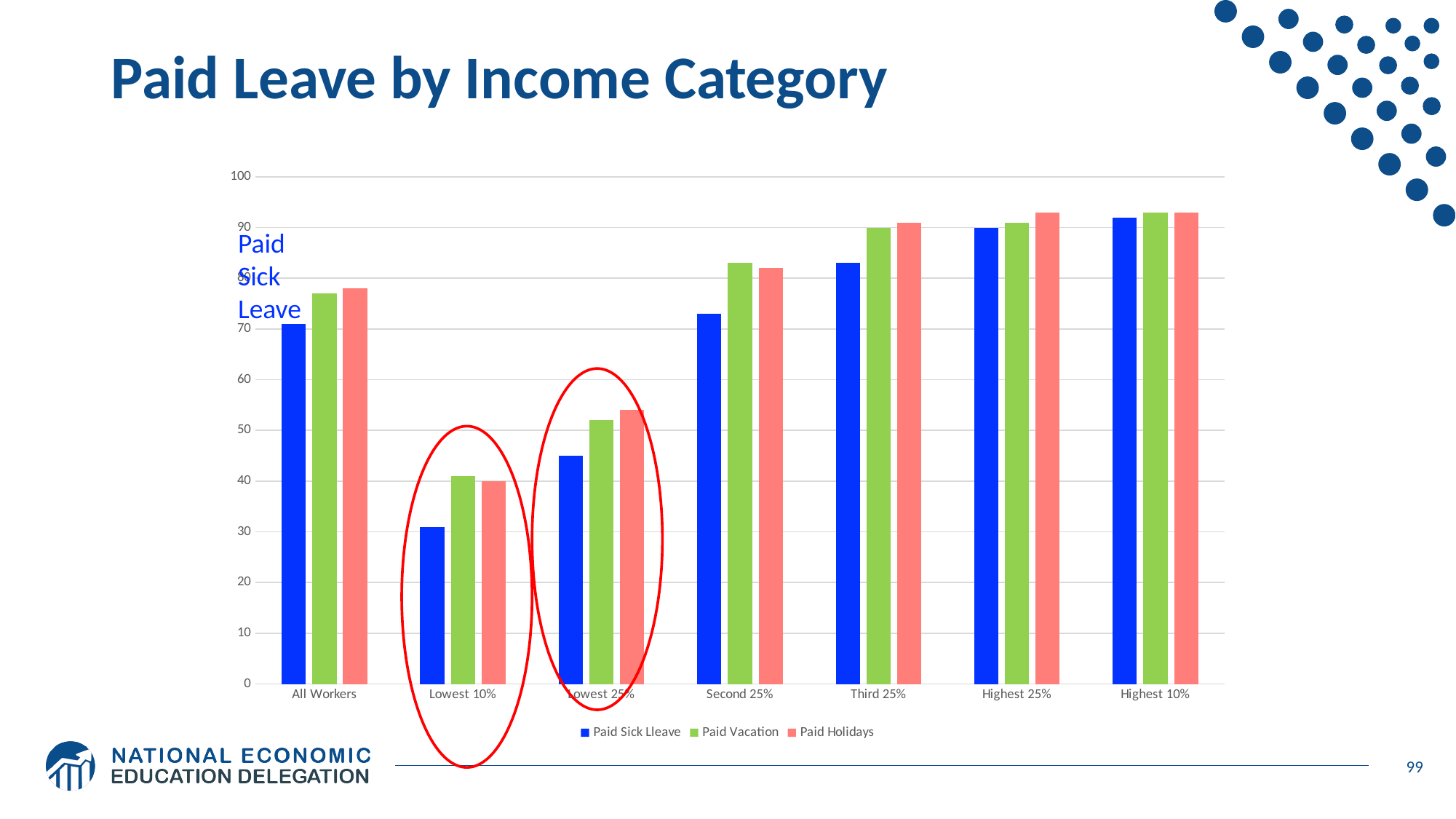
Which has the larger Paid Vacation value: Lowest 10% or Lowest 25%? Lowest 25% What kind of chart is shown on the slide? Bar chart Moving from Lowest 10% to Highest 10% along the x axis, do the Paid Sick Leave values rise or fall? Rise Is the Paid Holidays value for Lowest 25% greater or less than 50? greater How many income categories are shown along the x axis? 7 Is the Paid Sick Leave value for Second 25% greater or less than 80? less Is the Paid Vacation value for Third 25% greater or less than 80? greater Which category has the lowest Paid Sick Leave value? Lowest 10% How many series does the legend list? 3 Which two categories are circled in red on the chart? Lowest 10% and Lowest 25% For Lowest 10%, which is larger: Paid Sick Leave or Paid Vacation? Paid Vacation